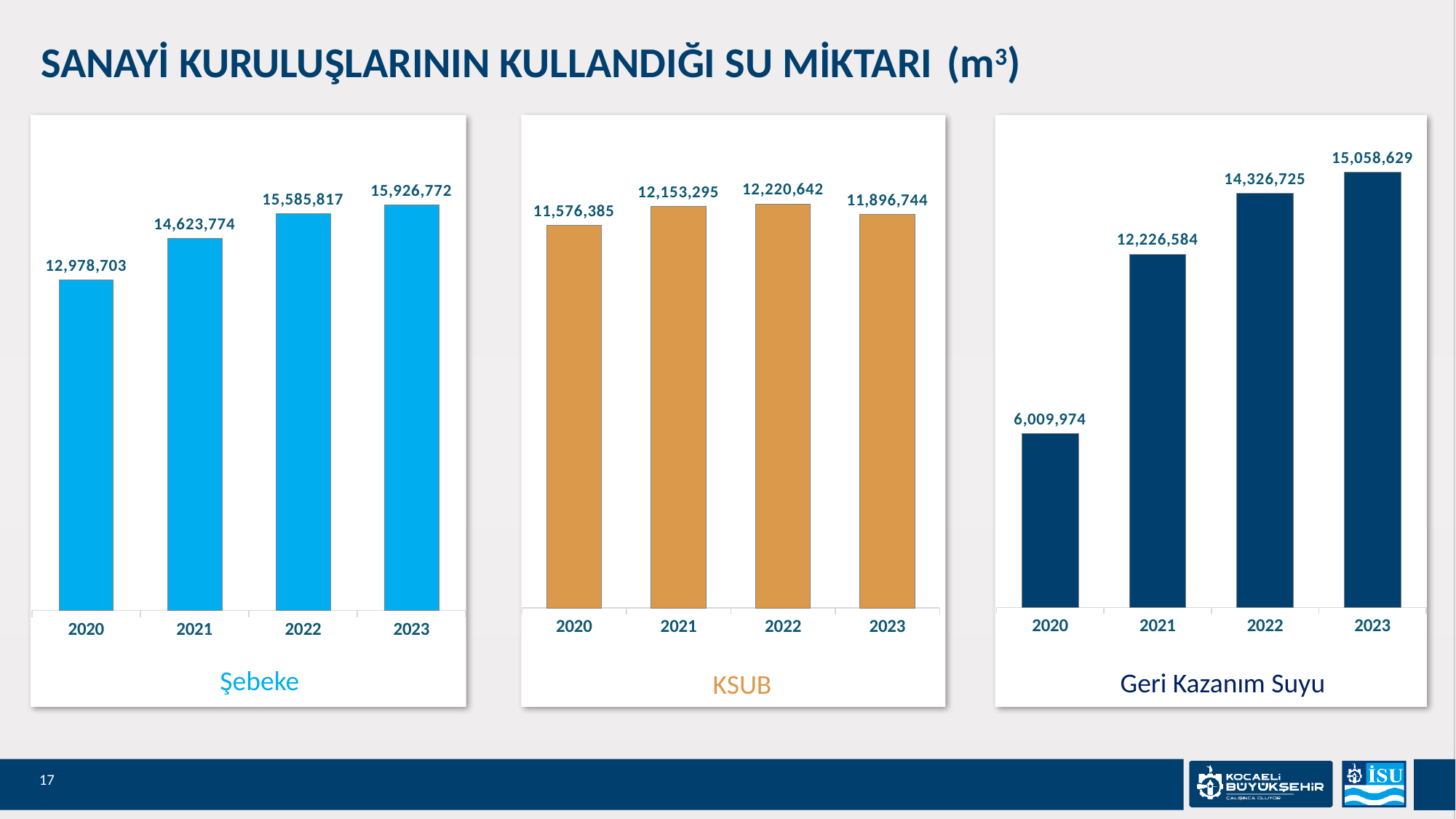
In the KSUB chart, which is larger, the value for 2022 or the value for 2023? 2022 What type of chart is the Şebeke chart? Bar chart How many years are shown in the Geri Kazanım Suyu chart? 4 In the Geri Kazanım Suyu chart, which year has the highest value? 2023 In the Şebeke chart, what is the value for 2021? 14,623,774 In the KSUB chart, what is the value for 2023? 11,896,744 In the Şebeke chart, what is the difference between the 2023 and 2020 values? 2,948,069 In the Geri Kazanım Suyu chart, what is the difference between the 2021 and 2020 values? 6,216,610 In the Geri Kazanım Suyu chart, do the values rise or fall from 2020 to 2023? Rise In the KSUB chart, which year has the lowest value? 2020 In the Geri Kazanım Suyu chart, what is the value for 2020? 6,009,974 In the Şebeke chart, which year has the highest value? 2023